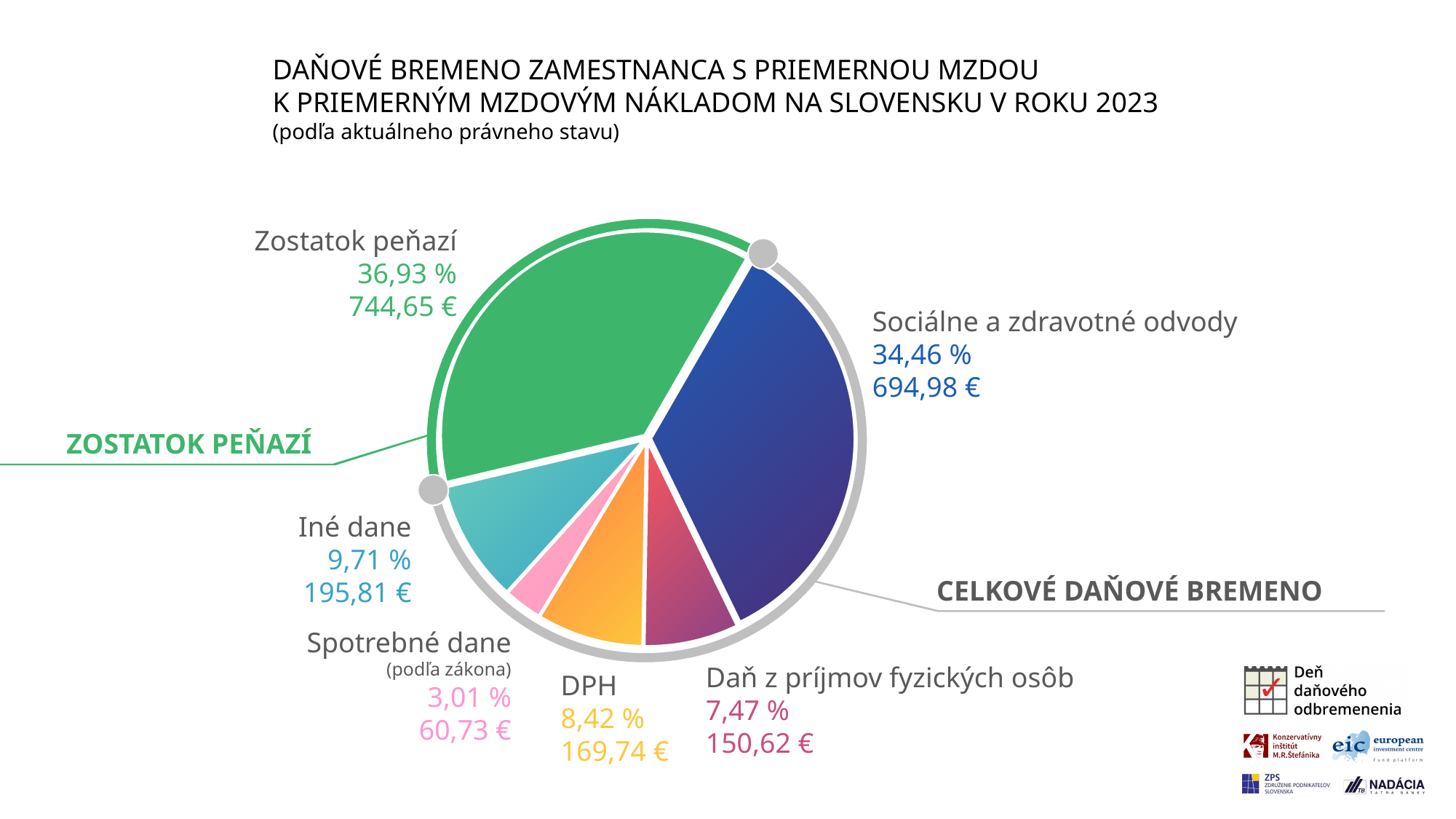
What euro amount is shown for DPH? 169,74 € What colour is the slice for Sociálne a zdravotné odvody? dark blue Which slice of the pie chart is the smallest? Spotrebné dane What percentage share is shown for Zostatok peňazí? 36,93 % How many slices does the pie chart have? 6 What is the difference in euros between Zostatok peňazí and Sociálne a zdravotné odvody? 49,67 € What percentage share is shown for Spotrebné dane? 3,01 % What euro amount is shown for Sociálne a zdravotné odvody? 694,98 € What kind of chart is shown on the slide? pie chart Which is larger, the share for Iné dane or the share for DPH? Iné dane Which slice of the pie chart is the largest? Zostatok peňazí What is the difference in percentage points between Iné dane and Daň z príjmov fyzických osôb? 2,24 %